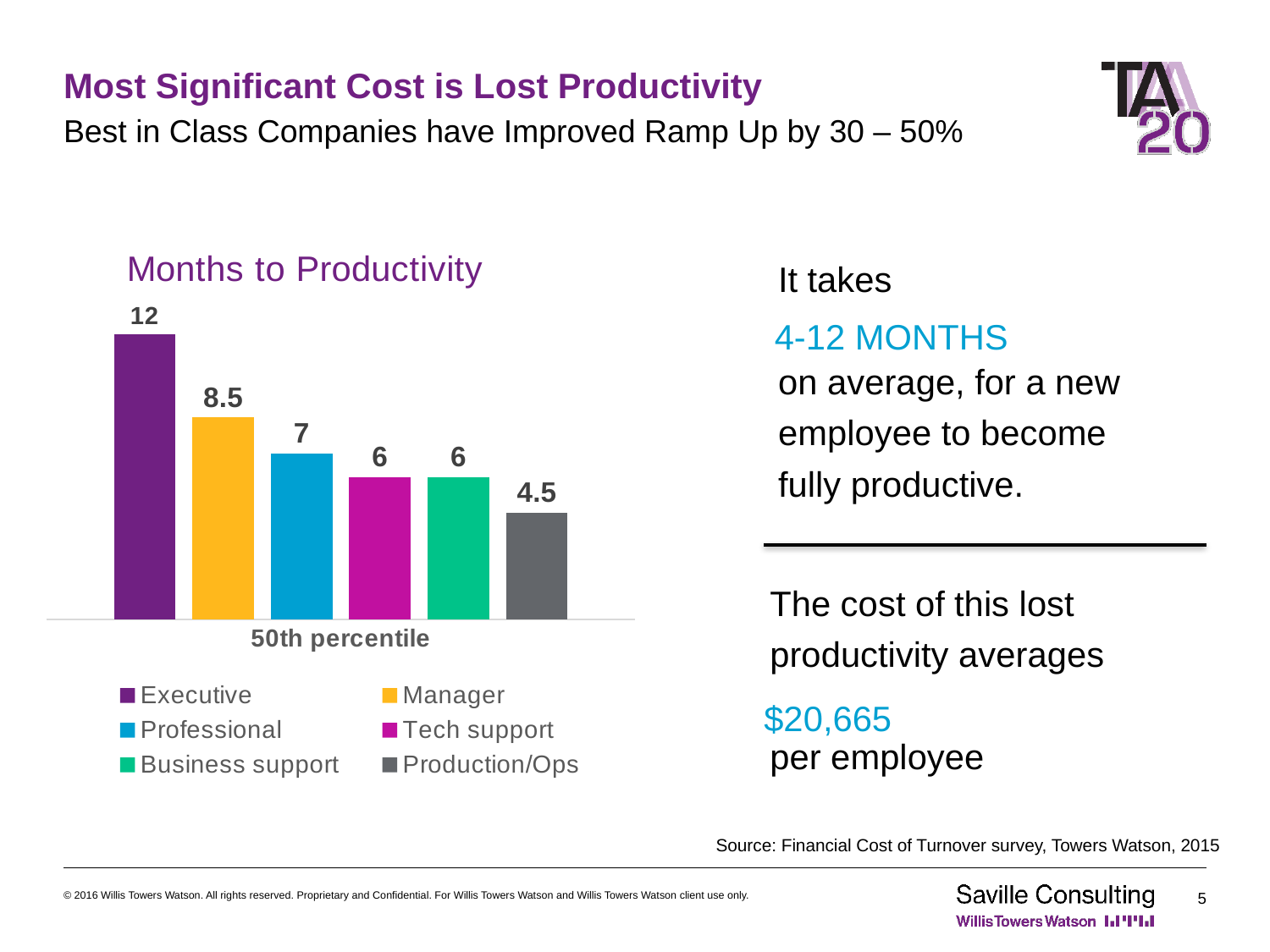
What is the x-axis category label shown under the bars in the Months to Productivity chart? 50th percentile What is the value for Manager in the Months to Productivity chart? 8.5 What is the difference between the Manager and Professional values in the Months to Productivity chart? 1.5 Which series has the highest value in the Months to Productivity chart? Executive What is the value for Production/Ops in the Months to Productivity chart? 4.5 What is the value for Executive in the Months to Productivity chart? 12 Which is larger in the Months to Productivity chart, Professional or Tech support? Professional How many series does the legend of the Months to Productivity chart list? 6 What is the title of the chart on the slide? Months to Productivity What kind of chart is the Months to Productivity chart? Bar chart Which series has the lowest value in the Months to Productivity chart? Production/Ops What is the difference between the Executive and Production/Ops values in the Months to Productivity chart? 7.5